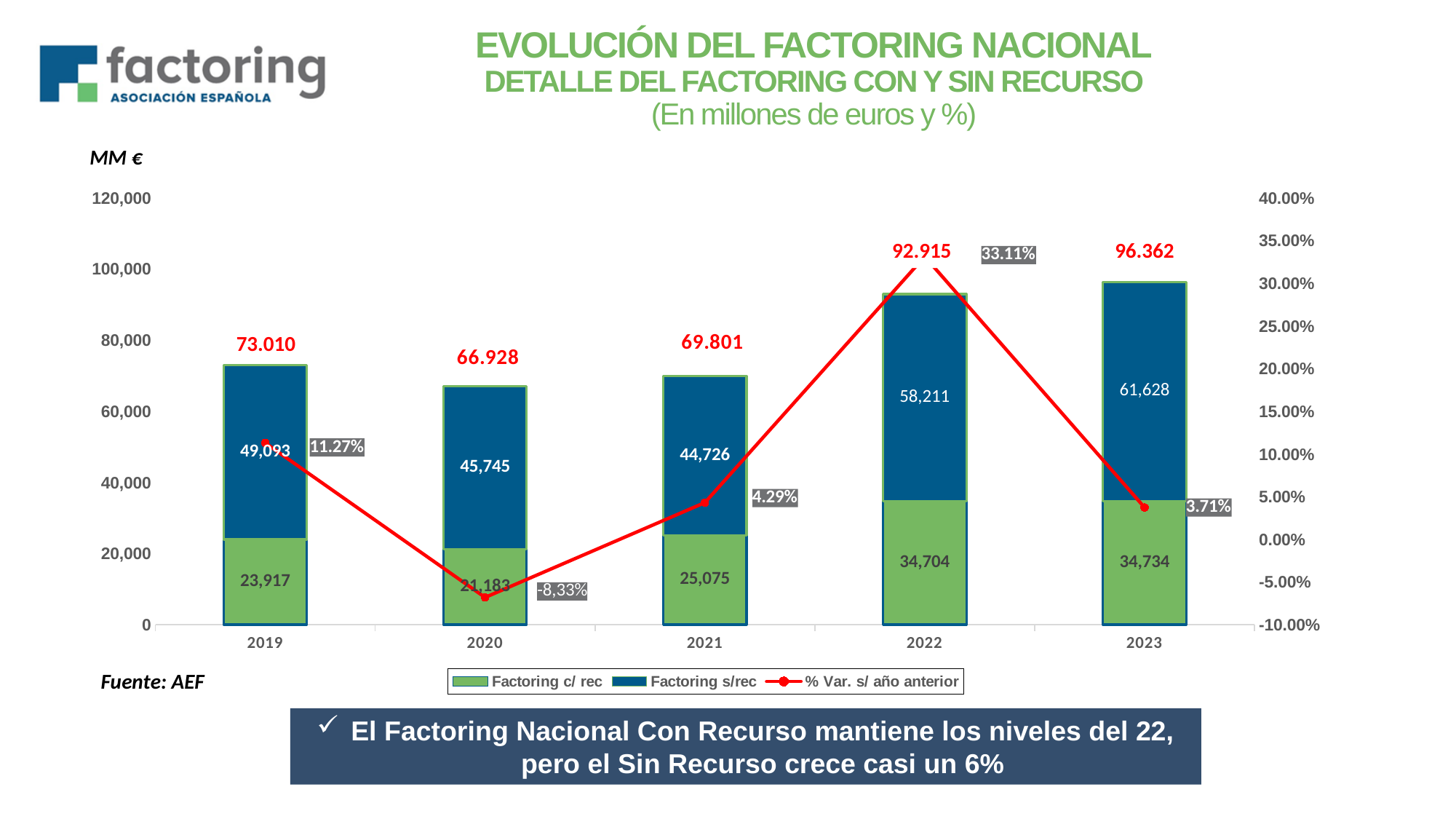
In which year is the Factoring c/ rec value lowest? 2020 What is the difference between the Factoring s/rec values for 2023 and 2022? 3,417 In which year is the % Var. s/ año anterior highest? 2022 What is the value of Factoring s/rec in 2020? 45,745 How many series does the legend list? 3 Which is larger, the Factoring c/ rec value for 2019 or for 2020? 2019 What is the value of Factoring c/ rec in 2022? 34,704 Does the Factoring s/rec value rise or fall from 2021 to 2023? rise How many years are shown on the x axis? 5 What is the total of the stacked bar for 2022, as labelled on the chart? 92.915 Is the total of the stacked bar for 2023 greater or less than 80,000? greater What is the % Var. s/ año anterior for 2021? 4.29%